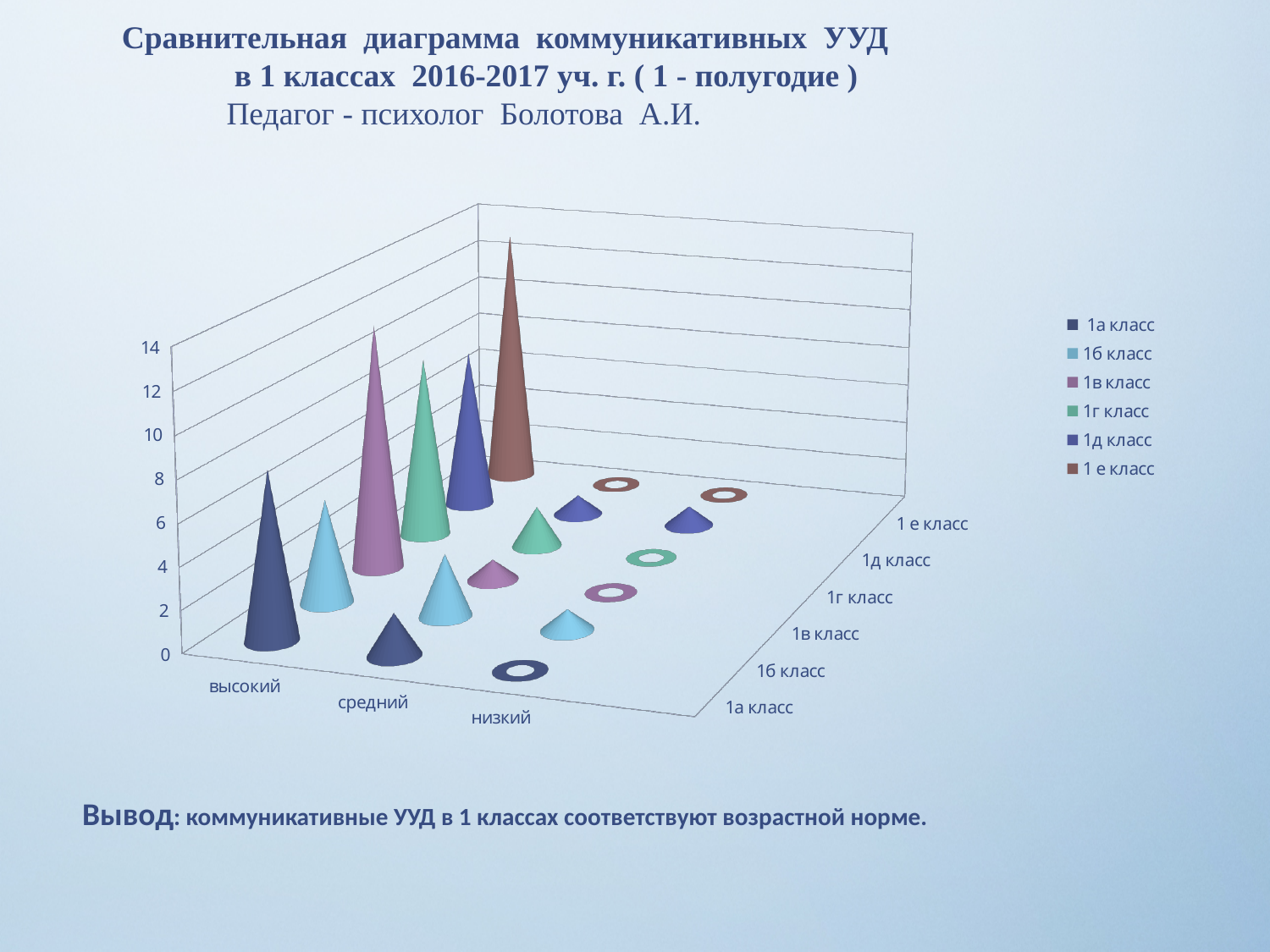
Is the value for 1а класс in the высокий category greater or less than 2? greater For 1а класс, do the values rise or fall going from высокий to низкий along the x axis? fall What kind of chart is shown on the slide? 3D bar chart (cone-shaped bars) For 1а класс, which category has the highest value? высокий In the высокий category, which is larger: the value for 1в класс or the value for 1б класс? 1в класс How many series does the legend list? 6 Is the value for 1а класс in the низкий category greater or less than 2? less For 1а класс, which category has the lowest value? низкий For 1в класс, which category has the highest value? высокий What is the highest value shown on the vertical axis? 14 How many categories are shown on the horizontal axis (высокий, средний, низкий)? 3 Which is larger for 1а класс: the value for высокий or the value for средний? высокий